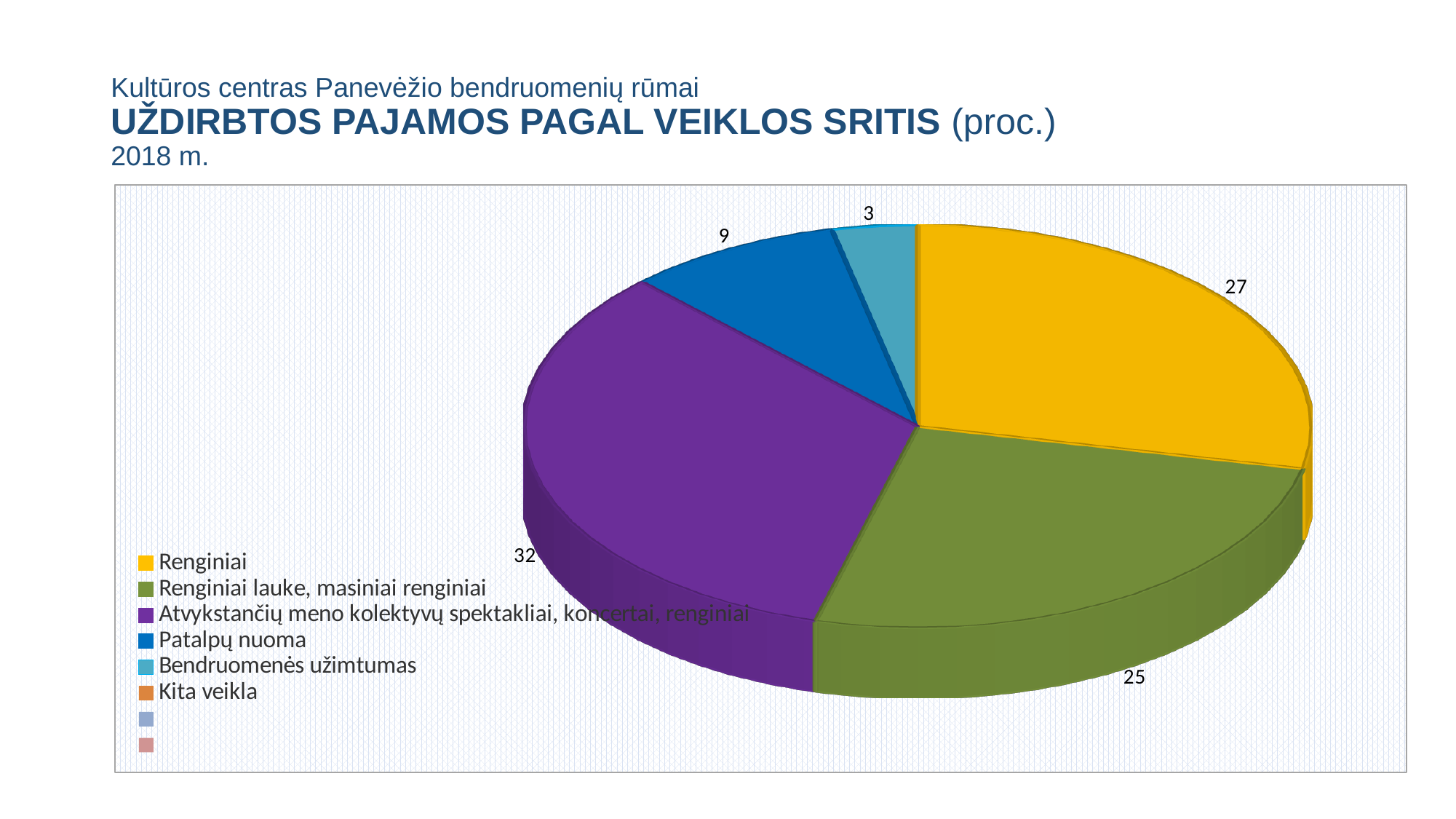
Which category has the largest slice of the pie? Atvykstančių meno kolektyvų spektakliai, koncertai, renginiai What is the difference between the values for Atvykstančių meno kolektyvų spektakliai, koncertai, renginiai and Patalpų nuoma? 23 What value is shown for the Patalpų nuoma slice? 9 What value is shown for the Renginiai lauke, masiniai renginiai slice? 25 What value is shown for the Bendruomenės užimtumas slice? 3 What is the difference between the values for Renginiai and Renginiai lauke, masiniai renginiai? 2 What colour is the Renginiai slice? Yellow Which is larger, the value for Renginiai or the value for Renginiai lauke, masiniai renginiai? Renginiai What value is shown for the Atvykstančių meno kolektyvų spektakliai, koncertai, renginiai slice? 32 What kind of chart is shown on the slide? Pie chart What value is shown for the Renginiai slice? 27 Which labelled slice of the pie is the smallest? Bendruomenės užimtumas